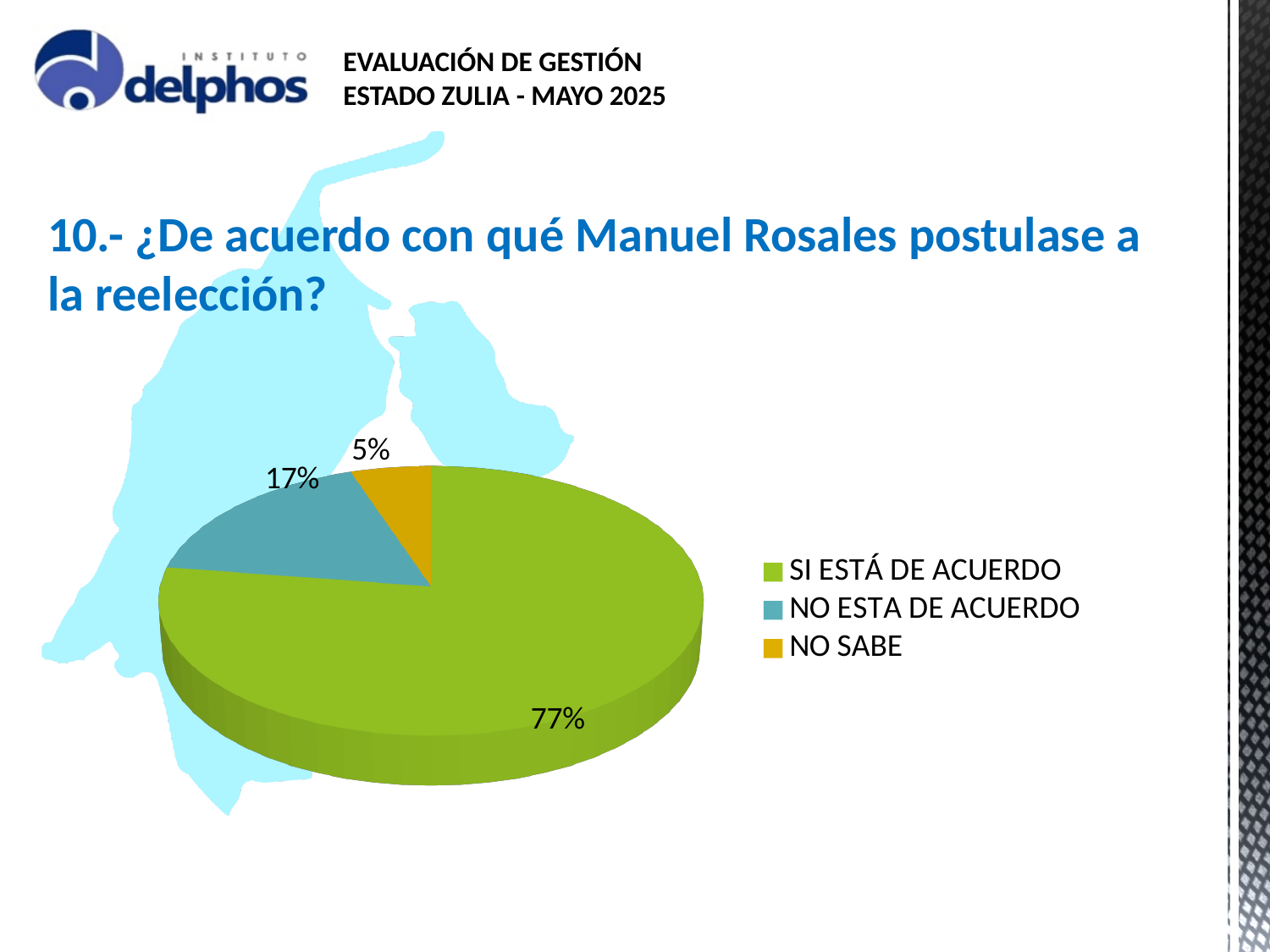
Which response category has the smallest share of the pie? NO SABE What percentage of respondents answered "NO ESTA DE ACUERDO"? 17% How many categories does the pie chart show? 3 Which is larger, the share for "NO ESTA DE ACUERDO" or the share for "NO SABE"? NO ESTA DE ACUERDO What percentage of respondents answered "NO SABE"? 5% What is the difference in percentage points between "SI ESTÁ DE ACUERDO" and "NO ESTA DE ACUERDO"? 60 What kind of chart is shown on the slide? Pie chart Which response category has the largest share of the pie? SI ESTÁ DE ACUERDO What is the difference in percentage points between "NO ESTA DE ACUERDO" and "NO SABE"? 12 What colour represents "SI ESTÁ DE ACUERDO" in the pie chart? Green What percentage of respondents answered "SI ESTÁ DE ACUERDO"? 77% What colour represents "NO SABE" in the pie chart? Yellow